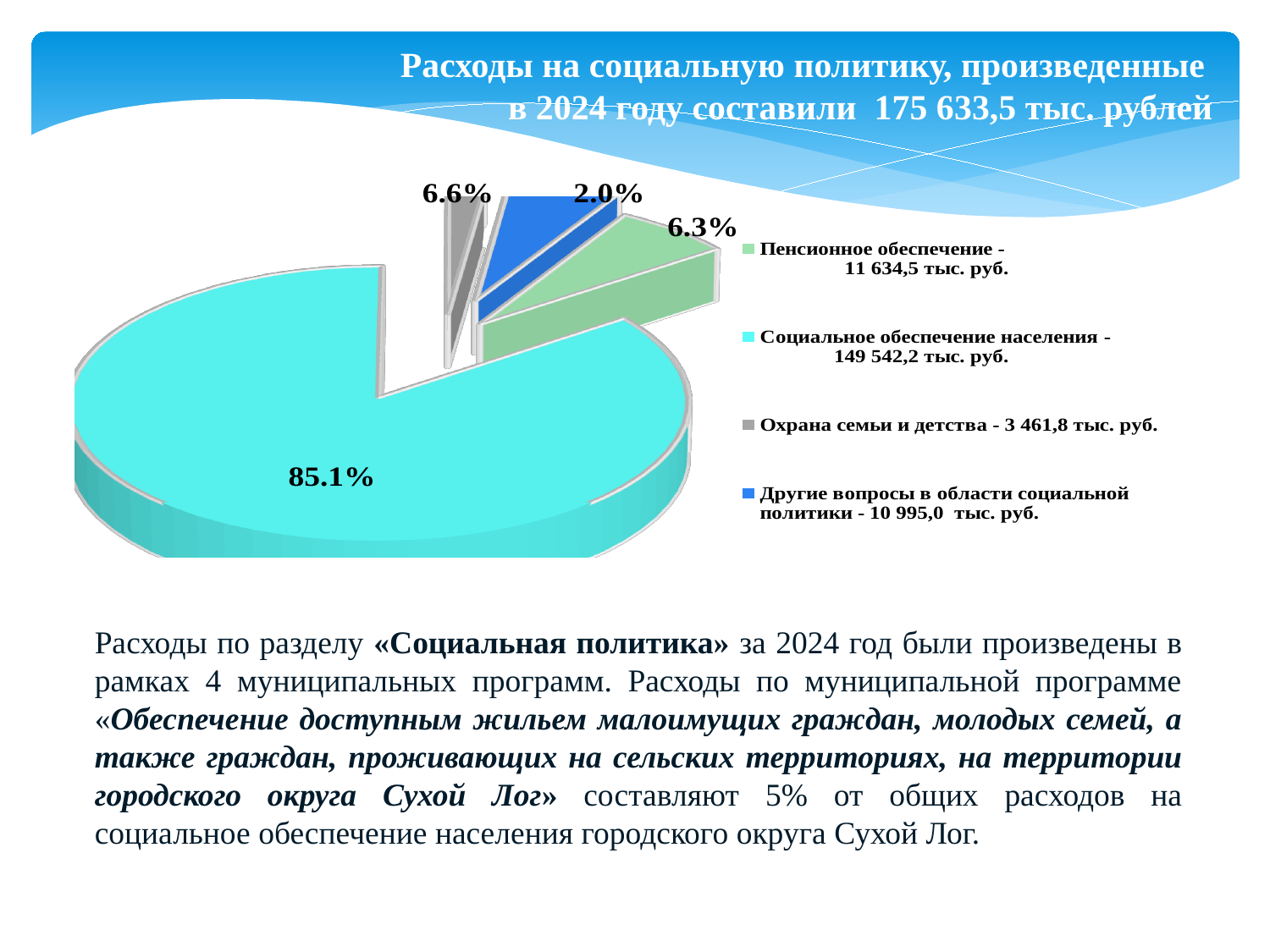
According to the legend, what is the value for Социальное обеспечение населения? 149 542,2 тыс. руб. Which category has the smallest value in the legend? Охрана семьи и детства What percentage share does the largest slice of the pie chart have? 85.1% Which is larger: the value for Пенсионное обеспечение or the value for Другие вопросы в области социальной политики? Пенсионное обеспечение How many slices does the pie chart have? 4 What kind of chart is shown on the slide? pie chart According to the legend, what is the value for Другие вопросы в области социальной политики? 10 995,0 тыс. руб. How many entries does the legend of the pie chart list? 4 According to the legend, what is the value for Охрана семьи и детства? 3 461,8 тыс. руб. Which category has the largest share of the pie chart? Социальное обеспечение населения According to the legend, what is the value for Пенсионное обеспечение? 11 634,5 тыс. руб. What total amount of social policy expenditure in 2024 is stated in the chart title? 175 633,5 тыс. рублей